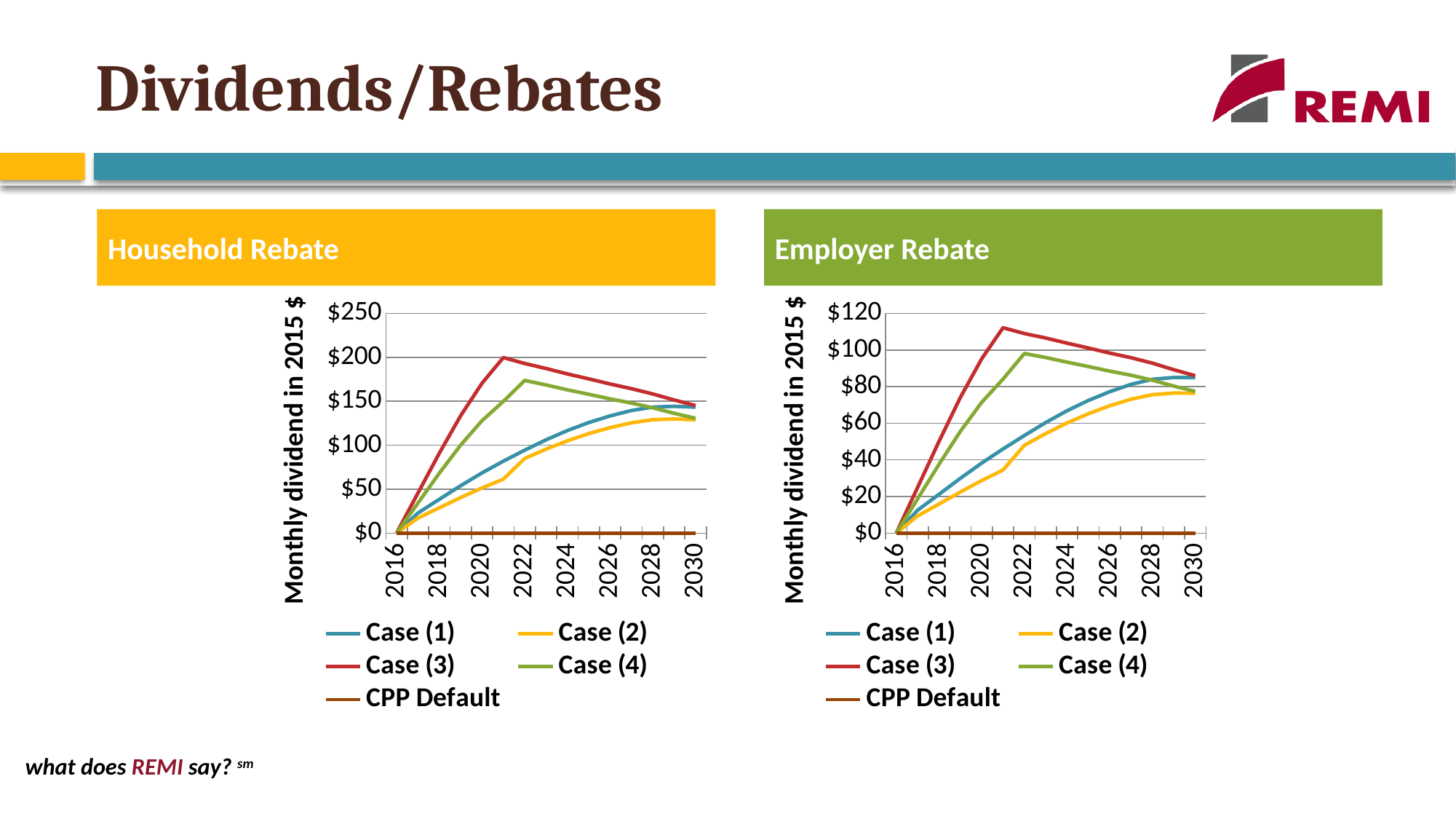
In the Household Rebate chart, is the value for Case (3) in 2021 greater or less than $150? greater In the Employer Rebate chart, does the Case (3) line rise or fall from 2021 to 2030? fall In the Household Rebate chart, does the Case (1) line rise or fall from 2016 to 2030? rise What is the y-axis label of the Employer Rebate chart? Monthly dividend in 2015 $ In the Employer Rebate chart, which is larger in 2022: Case (4) or Case (2)? Case (4) In the Household Rebate chart, is the value for Case (2) in 2030 greater or less than $150? less How many series does the legend of the Employer Rebate chart list? 5 What kind of chart is the Household Rebate chart? line chart In the Household Rebate chart, which is larger in 2021: Case (3) or Case (1)? Case (3) In the Household Rebate chart, what is the value of CPP Default across the years shown? $0 In the Employer Rebate chart, is the value for Case (3) in 2021 greater or less than $100? greater